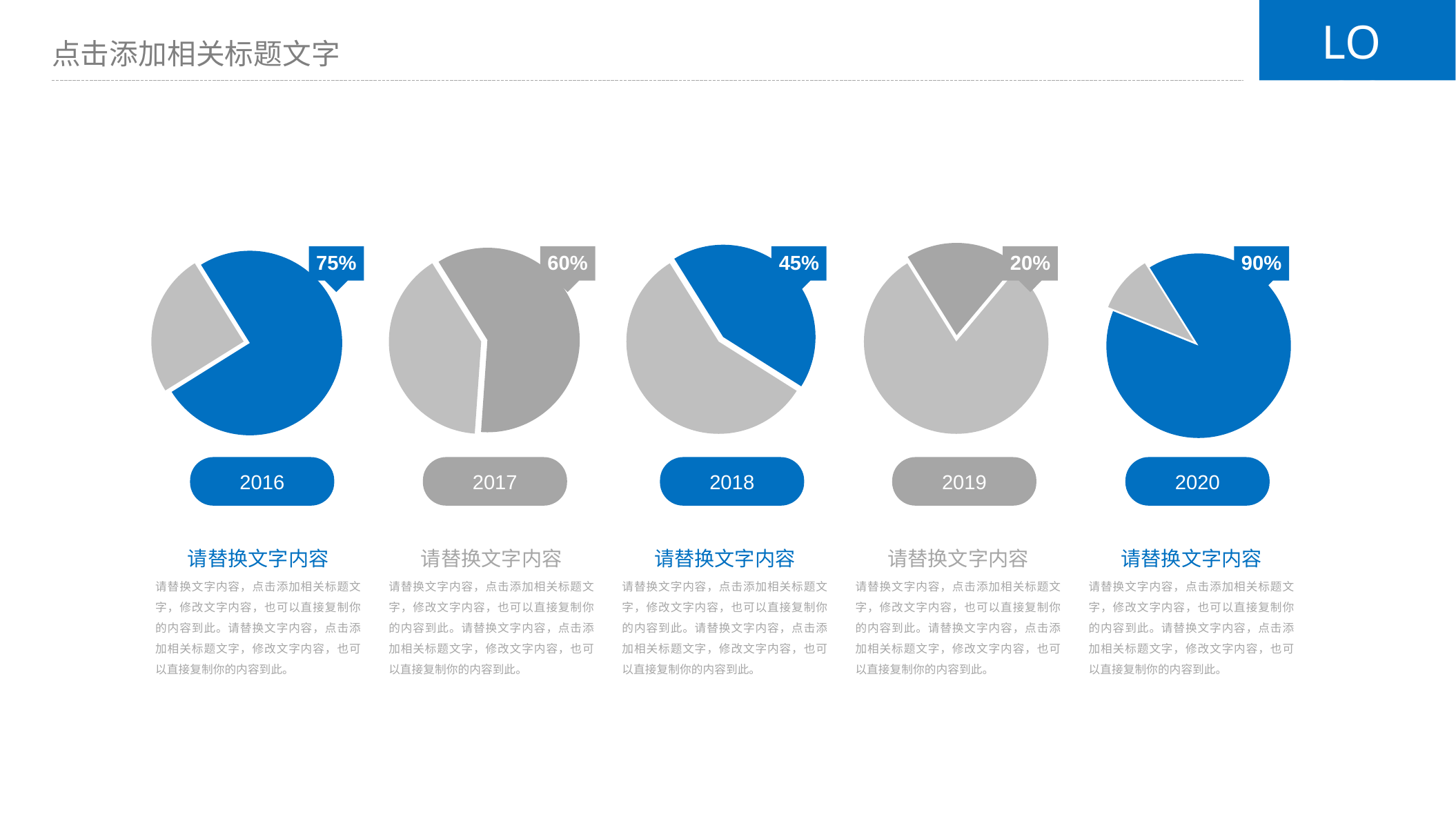
Which year's pie chart shows the lowest percentage? 2019 What percentage is shown on the pie chart labelled 2019? 20% Which year's pie chart shows the highest percentage? 2020 What percentage is shown on the pie chart labelled 2020? 90% What percentage is shown on the pie chart labelled 2017? 60% What percentage is shown on the pie chart labelled 2016? 75% How many pie charts are on the slide? 5 What percentage is shown on the pie chart labelled 2018? 45% What colour is the highlighted slice in the pie chart labelled 2018? Blue What kind of chart is used for each year on the slide? Pie chart Which pie chart shows a larger percentage, 2017 or 2018? 2017 What is the difference between the percentage shown for 2016 and the percentage shown for 2019? 55%